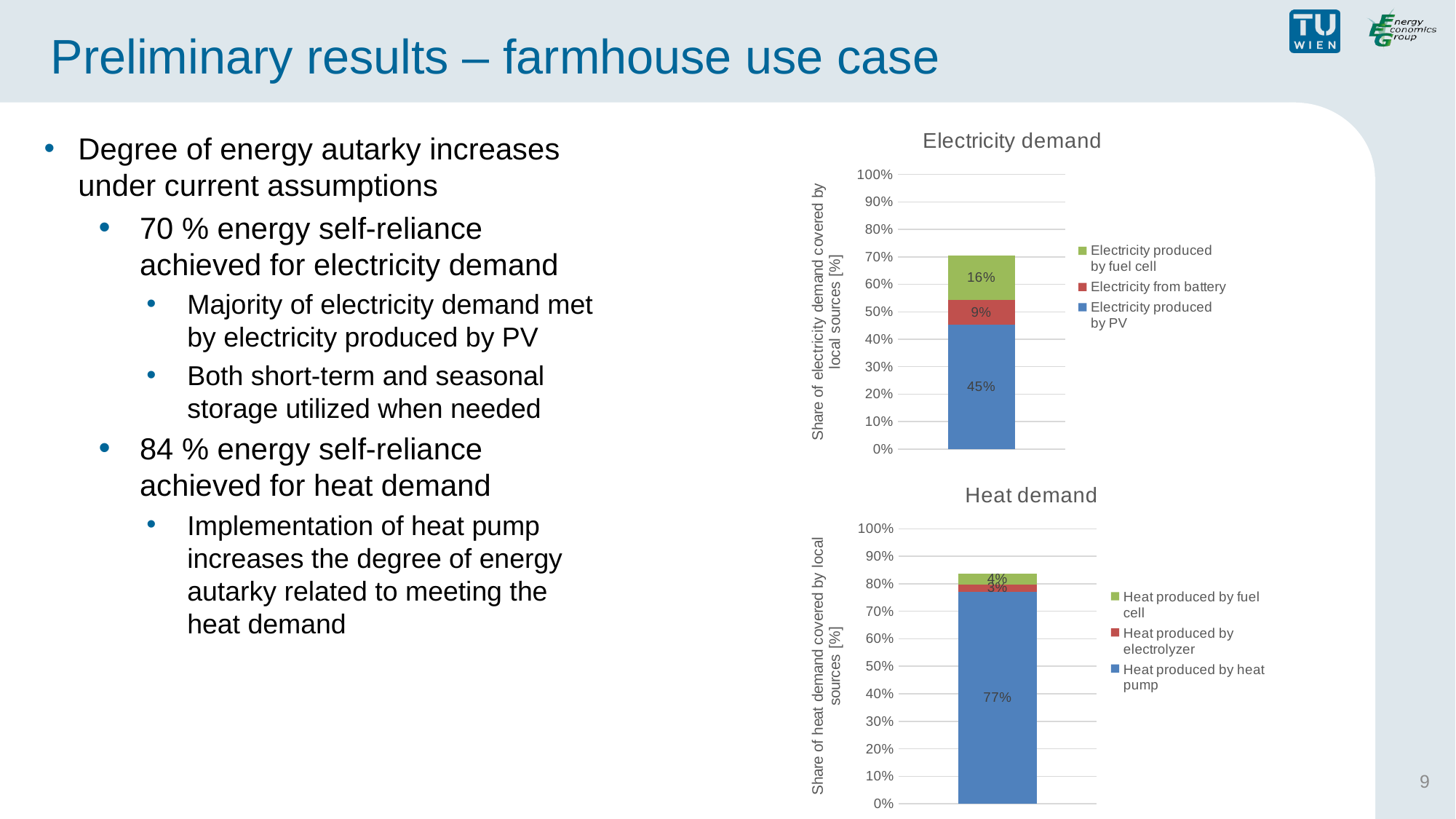
In the Heat demand chart, which source covers the smallest share of heat demand? Heat produced by electrolyzer In the Electricity demand chart, what share of electricity demand is covered by electricity produced by PV? 45% What kind of chart is the Electricity demand chart? Stacked bar chart In the Heat demand chart, what is the total share of heat demand covered by local sources (the full stacked bar)? 84% In the Heat demand chart, what share of heat demand is covered by heat produced by heat pump? 77% In the Electricity demand chart, what share is covered by electricity produced by fuel cell? 16% In the Electricity demand chart, what share is covered by electricity from battery? 9% In the Heat demand chart, what share is covered by heat produced by electrolyzer? 3% How many series does the legend of the Heat demand chart list? 3 In the Electricity demand chart, which source covers the largest share of electricity demand? Electricity produced by PV In the Electricity demand chart, what is the total share of electricity demand covered by local sources (the full stacked bar)? 70% In the Electricity demand chart, how much larger is the PV share than the fuel cell share? 29%